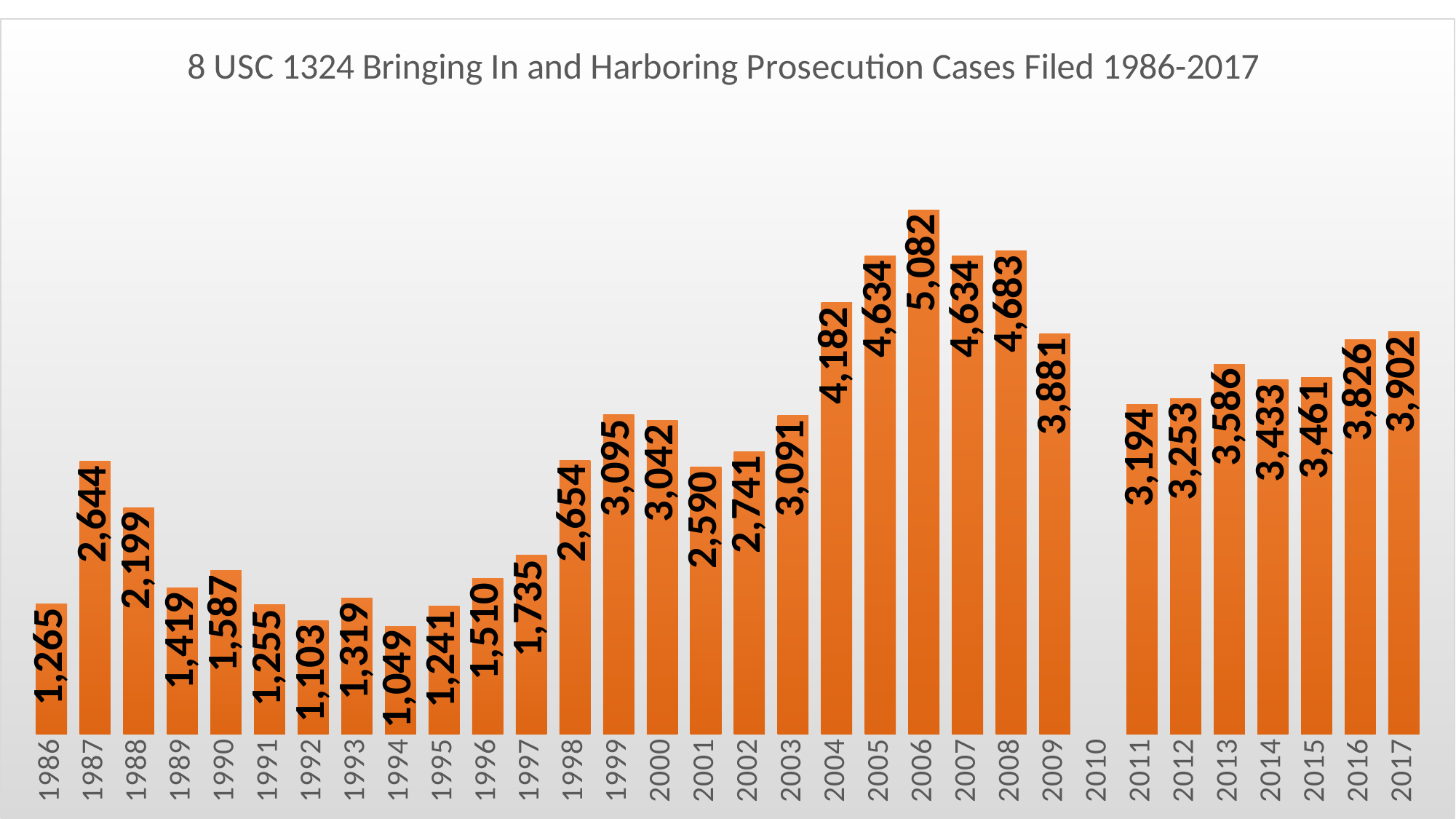
What is the difference between the values for 2017 and 2016? 76 What is the difference between the values for 2006 and 2005? 448 What kind of chart is this? bar chart Which year on the x axis has no bar plotted? 2010 Which year has the lowest number of cases filed? 1994 Do the values rise or fall from 2011 to 2013? rise Which year has the highest number of cases filed? 2006 What is the title of the chart? 8 USC 1324 Bringing In and Harboring Prosecution Cases Filed 1986-2017 What is the value for 1994? 1,049 Which is larger, the value for 1987 or the value for 1988? 1987 What is the value for 2006? 5,082 What is the value for 2017? 3,902